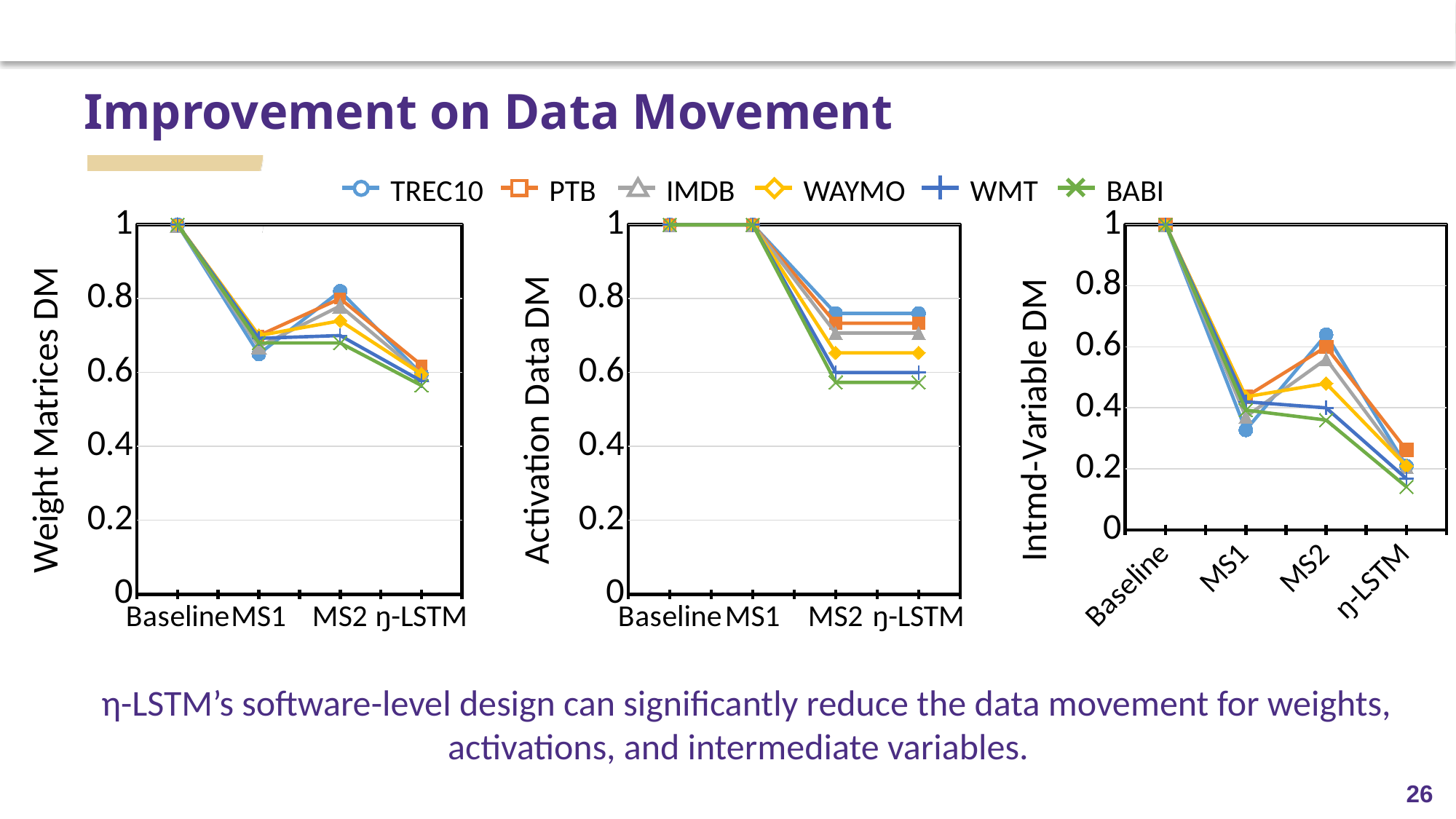
In the Intmd-Variable DM chart, which series has the lowest value at η-LSTM? BABI In the Activation Data DM chart, does the TREC10 line rise or fall from MS1 to MS2? fall In the Intmd-Variable DM chart, is the value for BABI at η-LSTM greater or less than 0.2? less What kind of chart is the left chart titled Weight Matrices DM? line chart How many series does the legend list? 6 In the Activation Data DM chart, what is the value for BABI at MS1? 1 In the Intmd-Variable DM chart, how many categories are on the x axis? 4 In the Activation Data DM chart, which series has the highest value at η-LSTM? TREC10 In the Activation Data DM chart, is the value for TREC10 at MS2 greater or less than 0.8? less In the Intmd-Variable DM chart, is the TREC10 value larger at MS2 or at η-LSTM? MS2 In the Intmd-Variable DM chart, is the value for TREC10 at MS2 greater or less than 0.6? greater In the Weight Matrices DM chart, what is the value for TREC10 at Baseline? 1